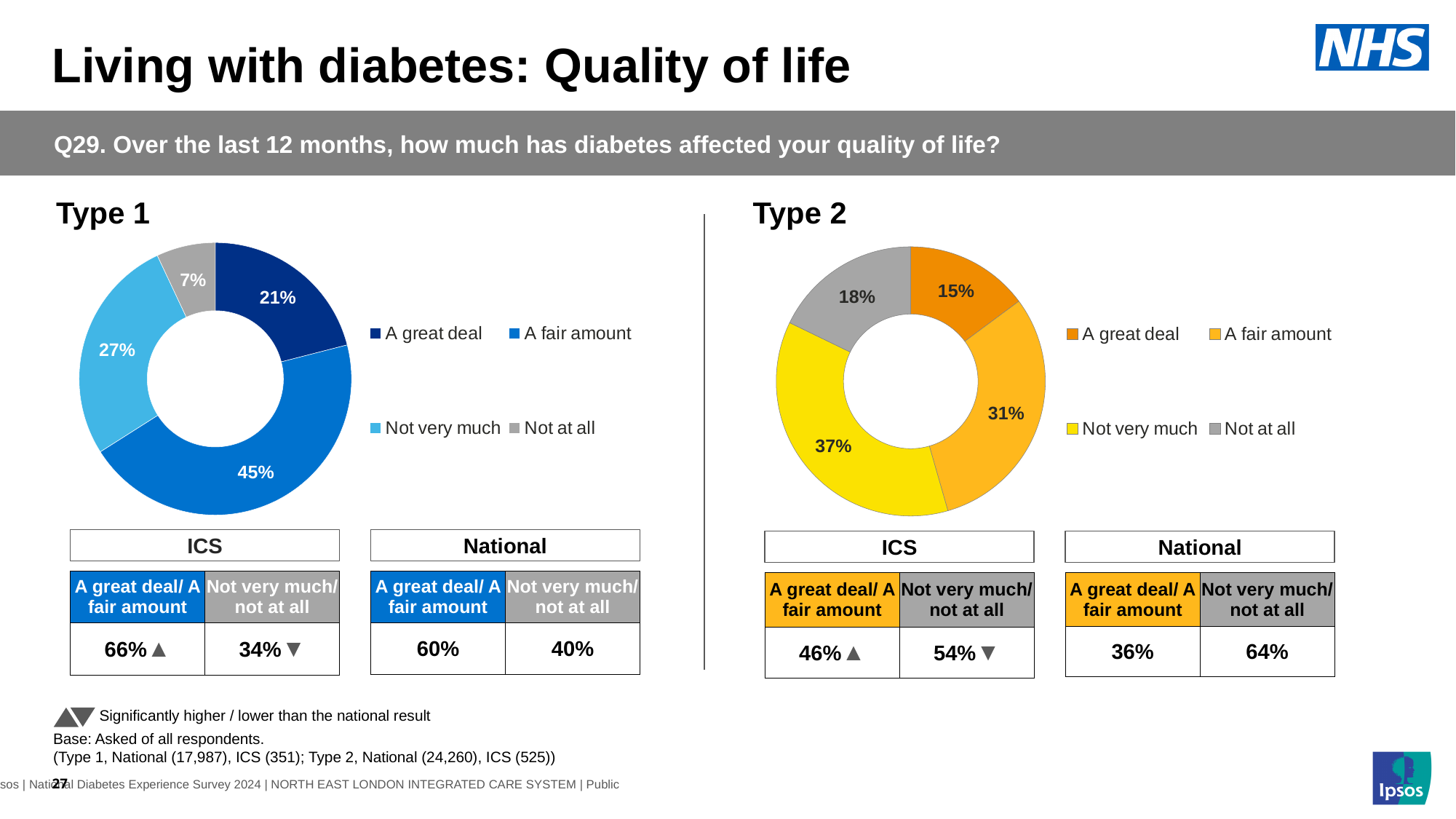
In the Type 1 chart, what is the difference between the 'A fair amount' and 'A great deal' shares? 24 percentage points How many categories does the Type 1 chart's legend list? 4 In the Type 2 chart, which category has the largest share? Not very much In the Type 1 chart, what is the combined share of 'A great deal' and 'A fair amount'? 66% In the Type 1 chart, which category has the smallest share? Not at all In the Type 1 chart, what percentage of respondents said diabetes affected their quality of life 'A fair amount'? 45% What kind of chart is used for the Type 2 data? Doughnut (pie) chart In the Type 2 chart, which is larger: 'A fair amount' or 'A great deal'? A fair amount In the Type 2 chart, what is the difference between the 'Not very much' and 'Not at all' shares? 19 percentage points In the Type 2 chart, what colour represents 'Not at all'? Grey In the Type 1 chart, which is larger: 'Not very much' or 'A great deal'? Not very much In the Type 2 chart, what percentage of respondents said 'Not very much'? 37%